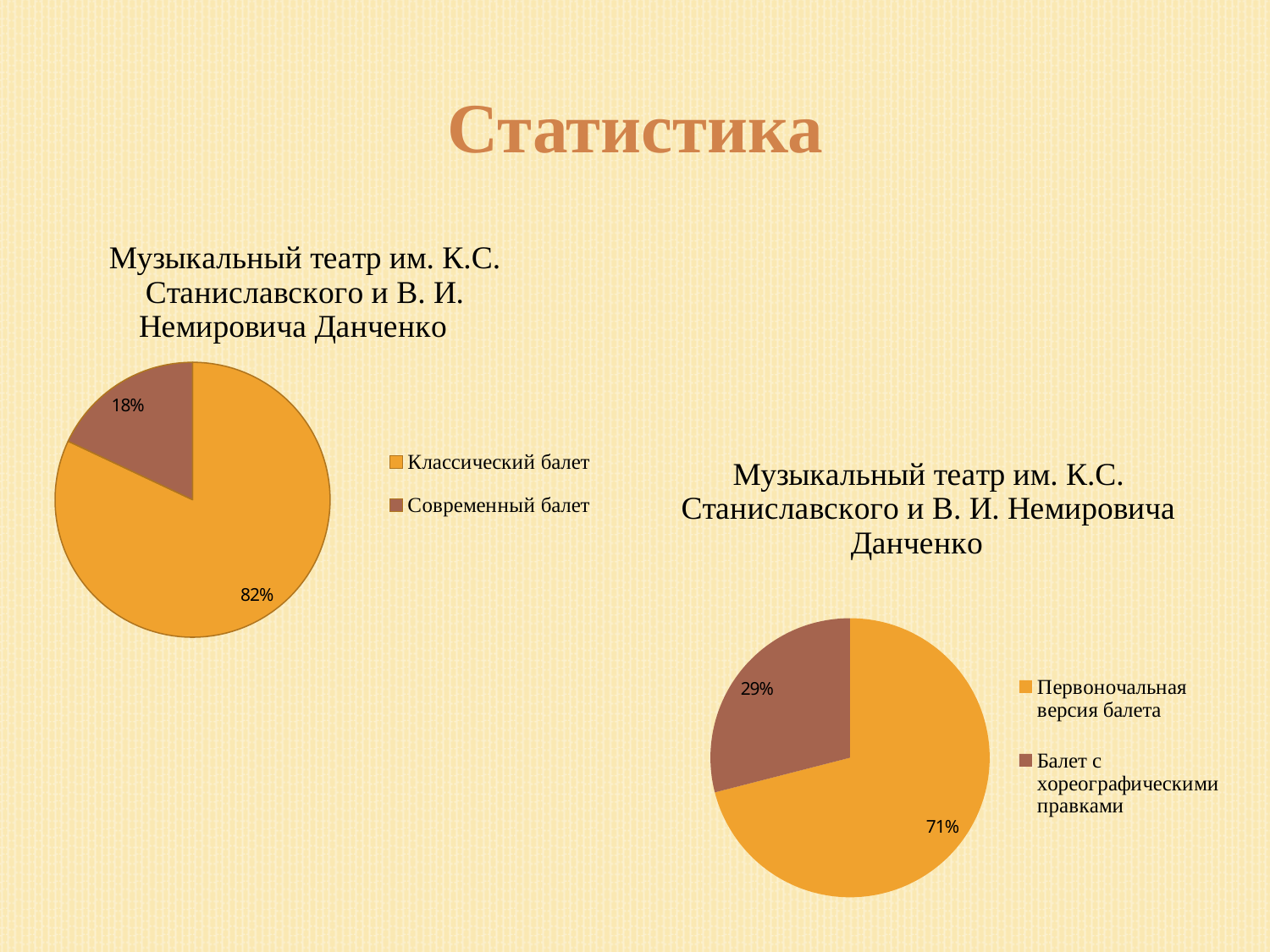
On the left pie chart, which category has the largest slice? Классический балет What type of chart is shown on the right side of the slide? Pie chart On the right pie chart, what share is labelled for Балет с хореографическими правками? 29% How many slices does the left pie chart have? 2 On the right pie chart, what share is labelled for Первоночальная версия балета? 71% How many entries does the legend of the right pie chart list? 2 On the right pie chart, which is larger: Первоночальная версия балета or Балет с хореографическими правками? Первоночальная версия балета On the left pie chart, what is the difference in percentage points between Классический балет and Современный балет? 64 On the left pie chart, what share is labelled for Классический балет? 82% On the left pie chart, what share is labelled for Современный балет? 18% On the right pie chart, which category has the smallest slice? Балет с хореографическими правками On the right pie chart, what is the difference in percentage points between Первоночальная версия балета and Балет с хореографическими правками? 42